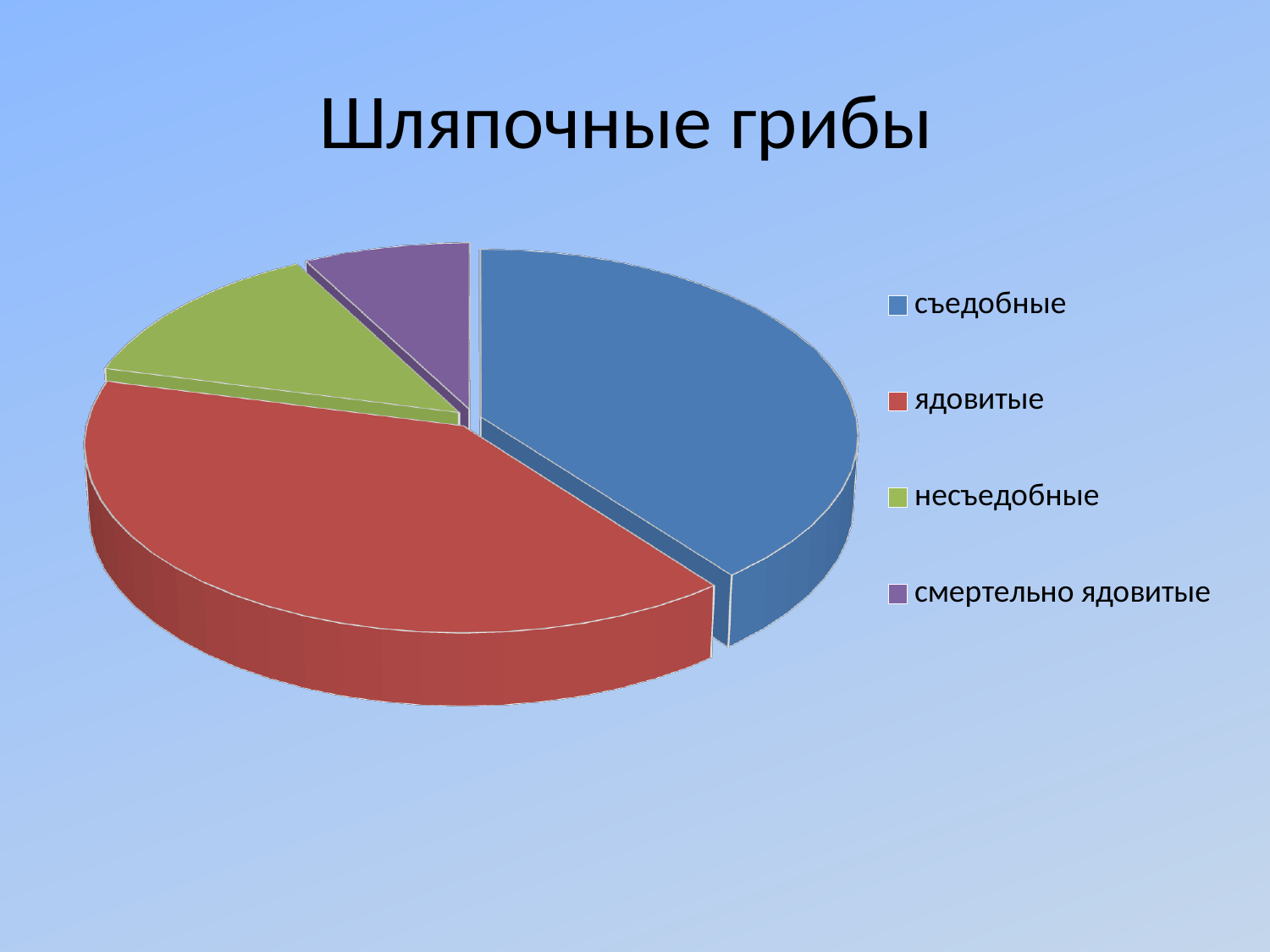
What kind of chart is shown on the slide? pie chart How many slices does the pie chart have? 4 Which slice is larger in the pie chart: ядовитые or несъедобные? ядовитые Which slice is larger in the pie chart: съедобные or несъедобные? съедобные Which colour represents the category ядовитые in the pie chart? red Which slice is larger in the pie chart: ядовитые or смертельно ядовитые? ядовитые Which category has the smallest slice in the pie chart? смертельно ядовитые How many entries does the legend of the pie chart list? 4 What is the title of the slide with the pie chart? Шляпочные грибы